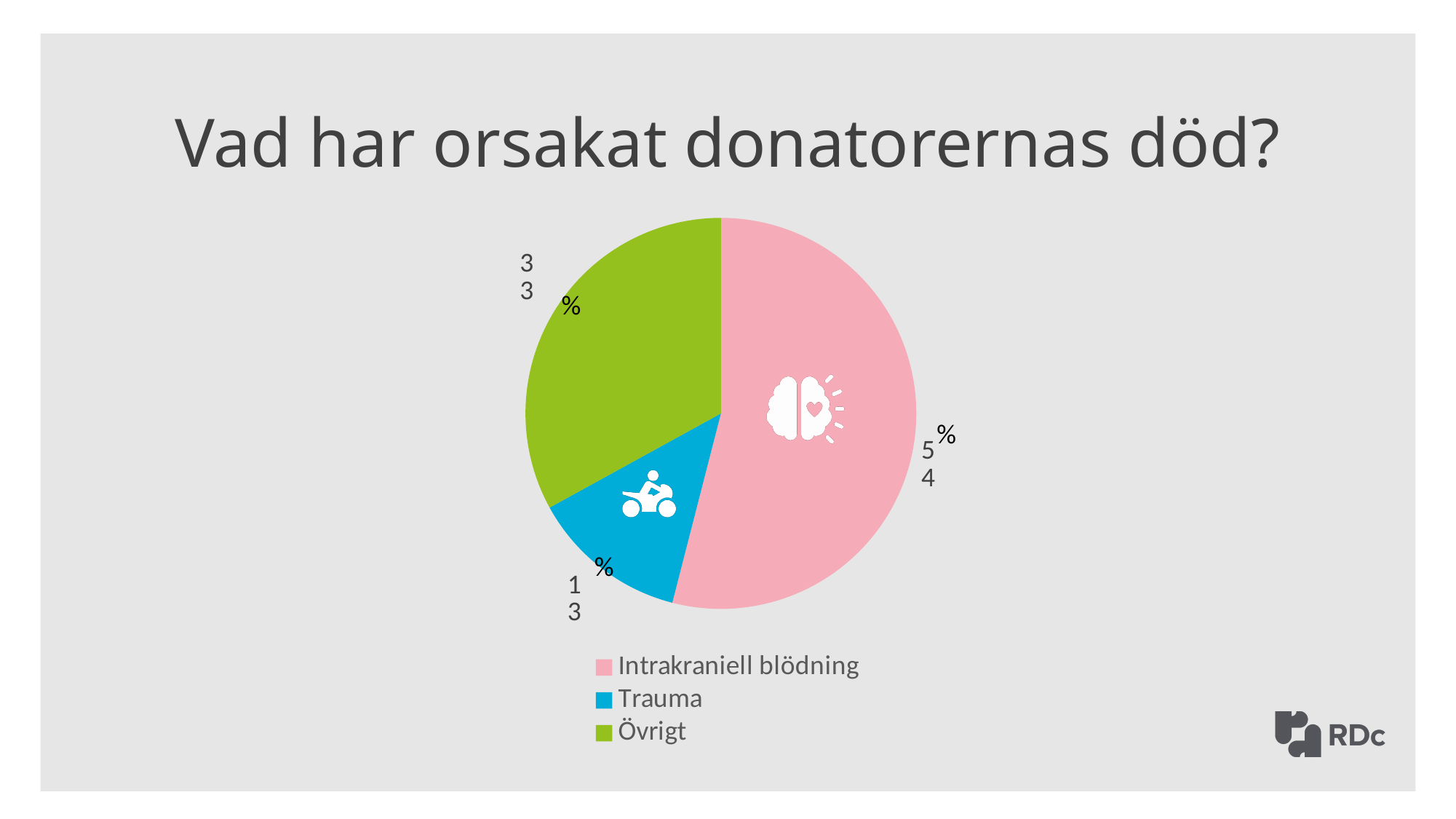
Which colour represents Trauma in the pie chart? blue How many entries does the legend list? 3 What kind of chart is shown on the slide? pie chart What is the difference in percentage points between Intrakraniell blödning and Övrigt? 21 Which category has the smallest share of the pie? Trauma What share of the pie is Övrigt? 33% What share of the pie is Trauma? 13% Which is larger, the share for Övrigt or the share for Trauma? Övrigt What is the title of the chart? Vad har orsakat donatorernas död? What share of the pie is Intrakraniell blödning? 54% Which category has the largest share of the pie? Intrakraniell blödning How many slices does the pie chart have? 3